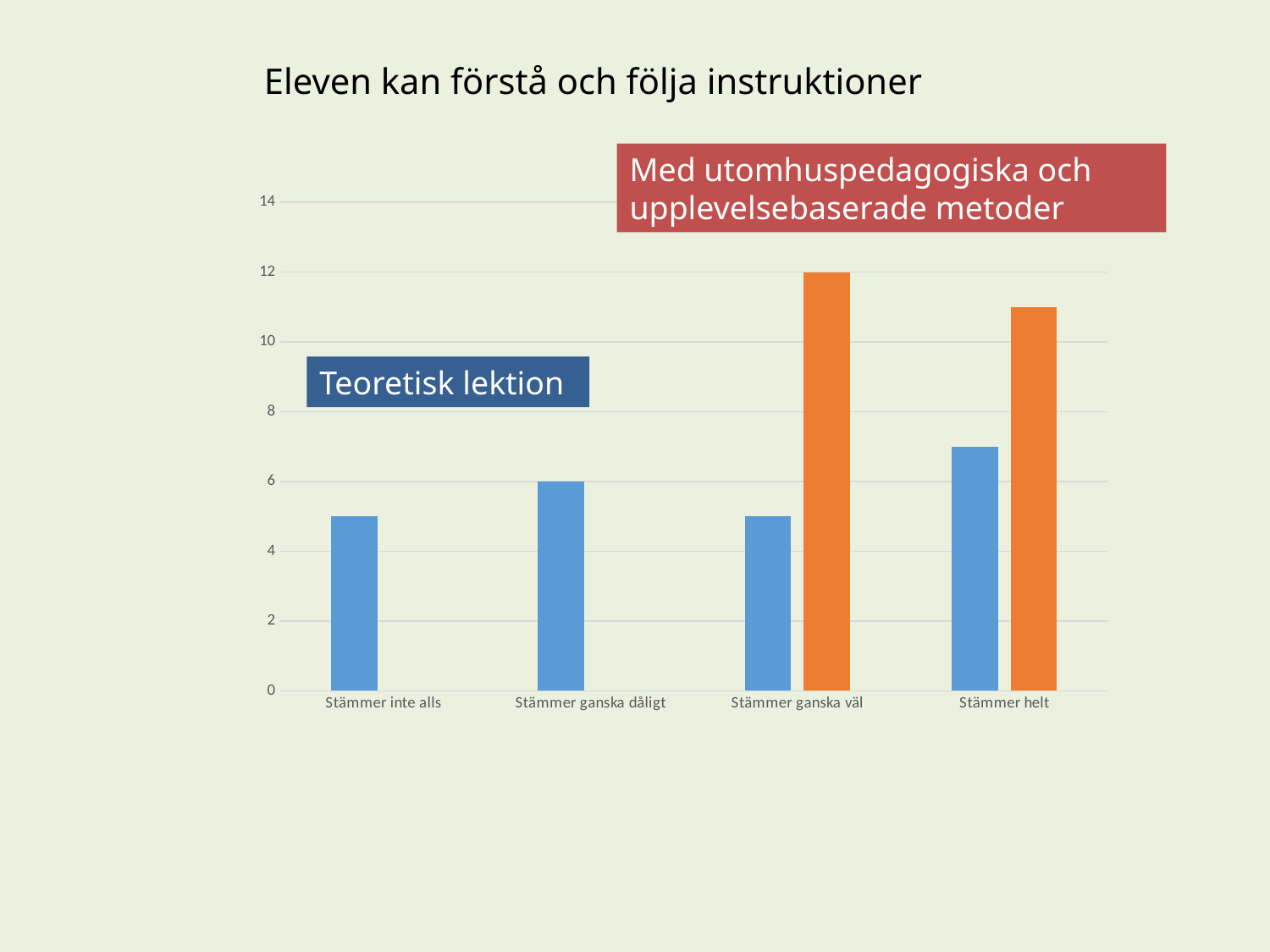
Is the value for Med utomhuspedagogiska och upplevelsebaserade metoder in the category Stämmer helt greater or less than 10? greater How many data series are plotted in the chart? 2 How many categories are shown on the x axis? 4 What colour are the bars for the Teoretisk lektion series? blue What is the value for Teoretisk lektion in the category Stämmer ganska dåligt? 6 What is the title of the chart? Eleven kan förstå och följa instruktioner What kind of chart is shown on the slide? bar chart Which category has the highest value for Teoretisk lektion? Stämmer helt In the category Stämmer helt, which series has the larger value: Teoretisk lektion or Med utomhuspedagogiska och upplevelsebaserade metoder? Med utomhuspedagogiska och upplevelsebaserade metoder What is the value for Med utomhuspedagogiska och upplevelsebaserade metoder in the category Stämmer ganska väl? 12 Is the value for Teoretisk lektion in the category Stämmer helt greater or less than 8? less Which category has the highest bar in the chart? Stämmer ganska väl